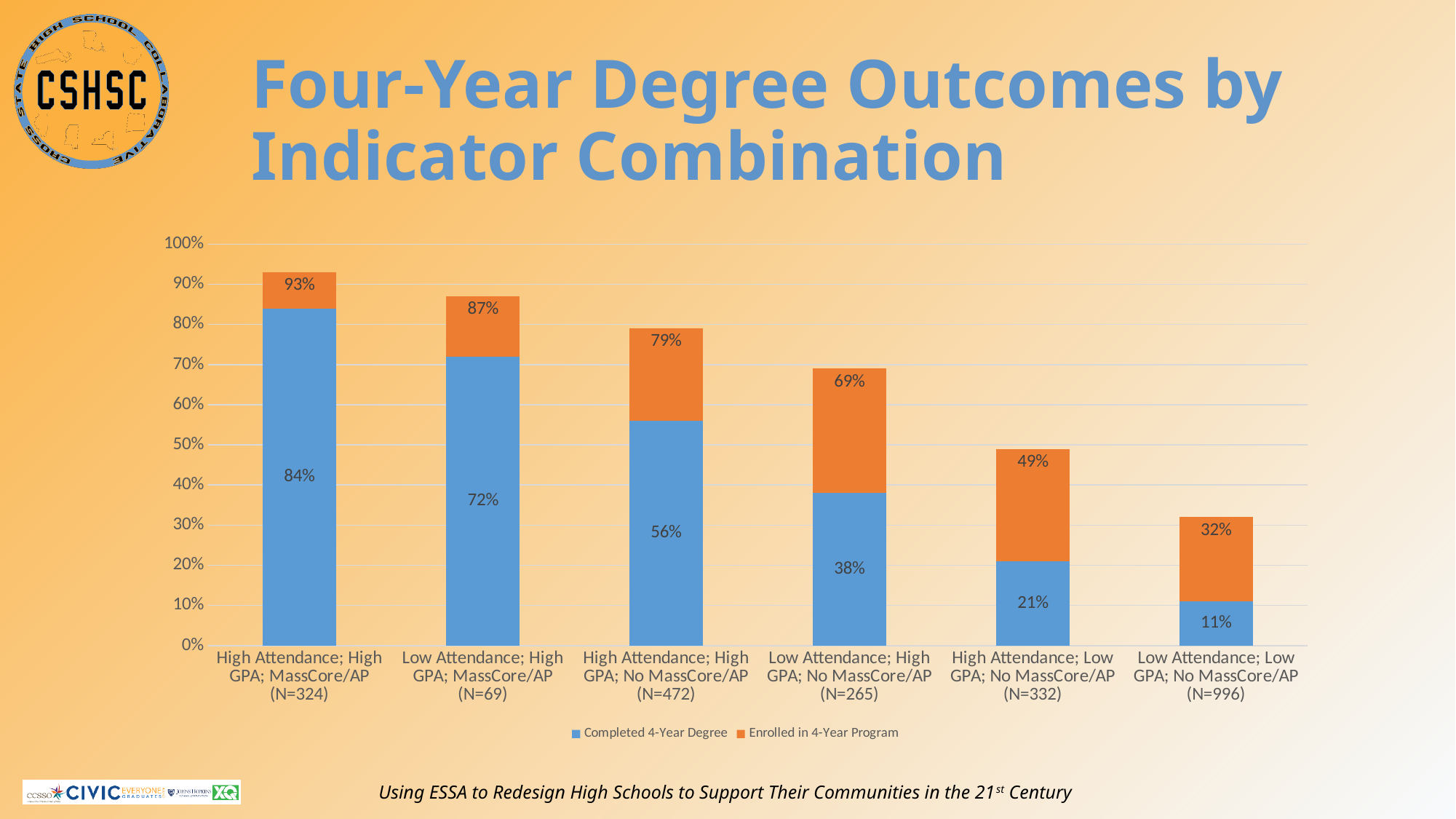
What is the Completed 4-Year Degree value for High Attendance; High GPA; MassCore/AP (N=324)? 84% What total does the stacked bar for High Attendance; High GPA; MassCore/AP (N=324) reach, as labelled at its top? 93% What is the Completed 4-Year Degree value for Low Attendance; High GPA; No MassCore/AP (N=265)? 38% What kind of chart is shown on the slide? Stacked bar chart What is the difference between the Completed 4-Year Degree values for Low Attendance; High GPA; MassCore/AP (N=69) and High Attendance; High GPA; No MassCore/AP (N=472)? 16% Which is larger, the Completed 4-Year Degree value for High Attendance; Low GPA; No MassCore/AP (N=332) or for Low Attendance; High GPA; No MassCore/AP (N=265)? Low Attendance; High GPA; No MassCore/AP (N=265) How many indicator combinations are shown on the x axis? 6 How many series does the legend list? 2 What is the Completed 4-Year Degree value for Low Attendance; Low GPA; No MassCore/AP (N=996)? 11% Which indicator combination has the lowest Completed 4-Year Degree value? Low Attendance; Low GPA; No MassCore/AP (N=996) Do the Completed 4-Year Degree values rise or fall from left to right across the x axis? Fall Which indicator combination has the highest Completed 4-Year Degree value? High Attendance; High GPA; MassCore/AP (N=324)